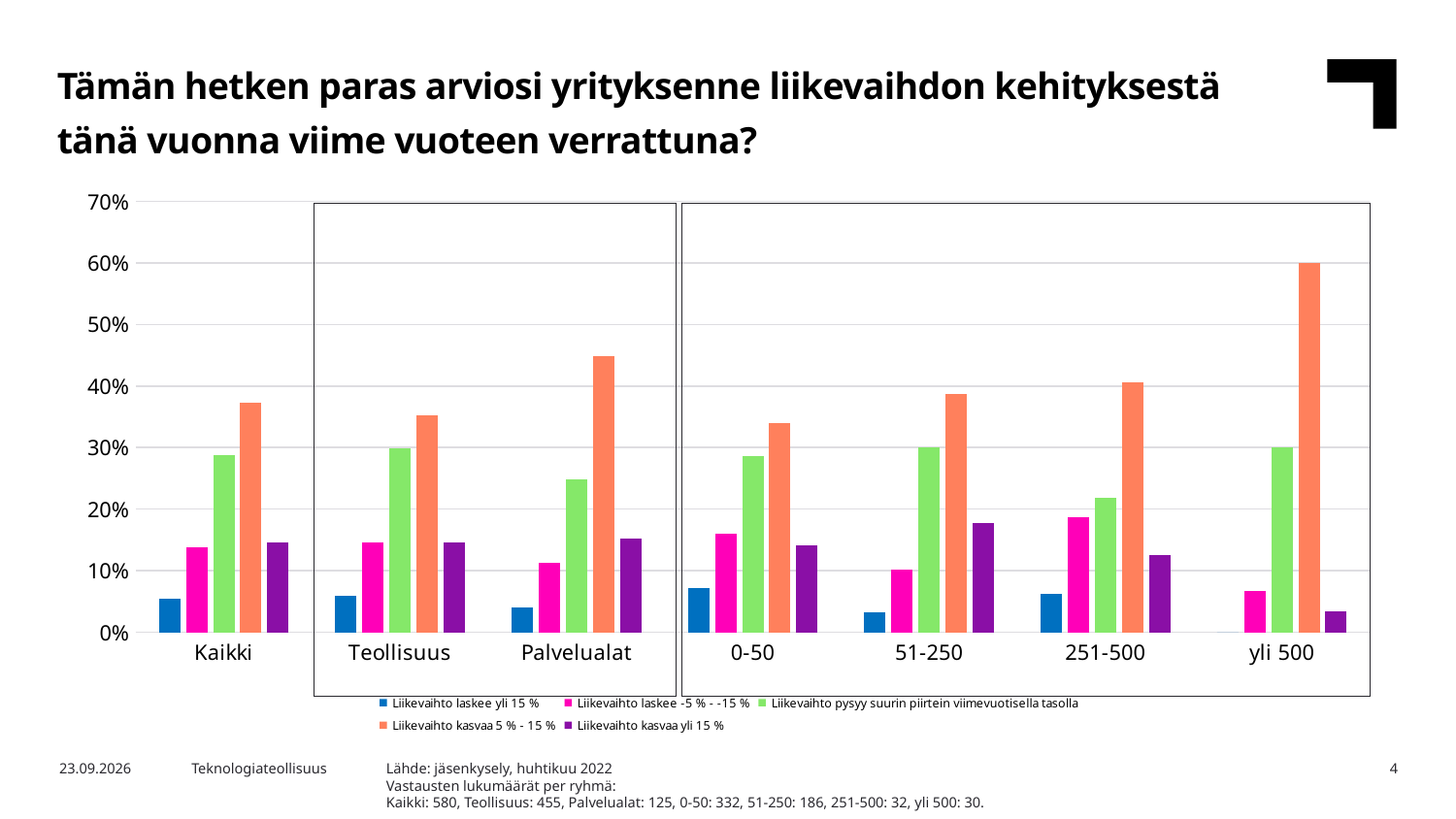
Which category has the highest bar for "Liikevaihto kasvaa 5 % - 15 %"? yli 500 How many series does the legend list? 5 Is the value for "Liikevaihto kasvaa 5 % - 15 %" in the yli 500 category greater or less than 50%? greater Which category has the lowest bar for "Liikevaihto kasvaa yli 15 %"? yli 500 Is the value for "Liikevaihto laskee yli 15 %" in the Kaikki category greater or less than 10%? less Is the value for "Liikevaihto pysyy suurin piirtein viimevuotisella tasolla" in the 251-500 category greater or less than 30%? less In the Palvelualat category, which is larger: "Liikevaihto pysyy suurin piirtein viimevuotisella tasolla" or "Liikevaihto kasvaa 5 % - 15 %"? Liikevaihto kasvaa 5 % - 15 % What colour represents the series "Liikevaihto kasvaa yli 15 %" in the legend? purple How many categories are shown along the x axis? 7 What kind of chart is shown on the slide? bar chart In the 51-250 category, which is larger: "Liikevaihto laskee -5 % - -15 %" or "Liikevaihto kasvaa yli 15 %"? Liikevaihto kasvaa yli 15 %